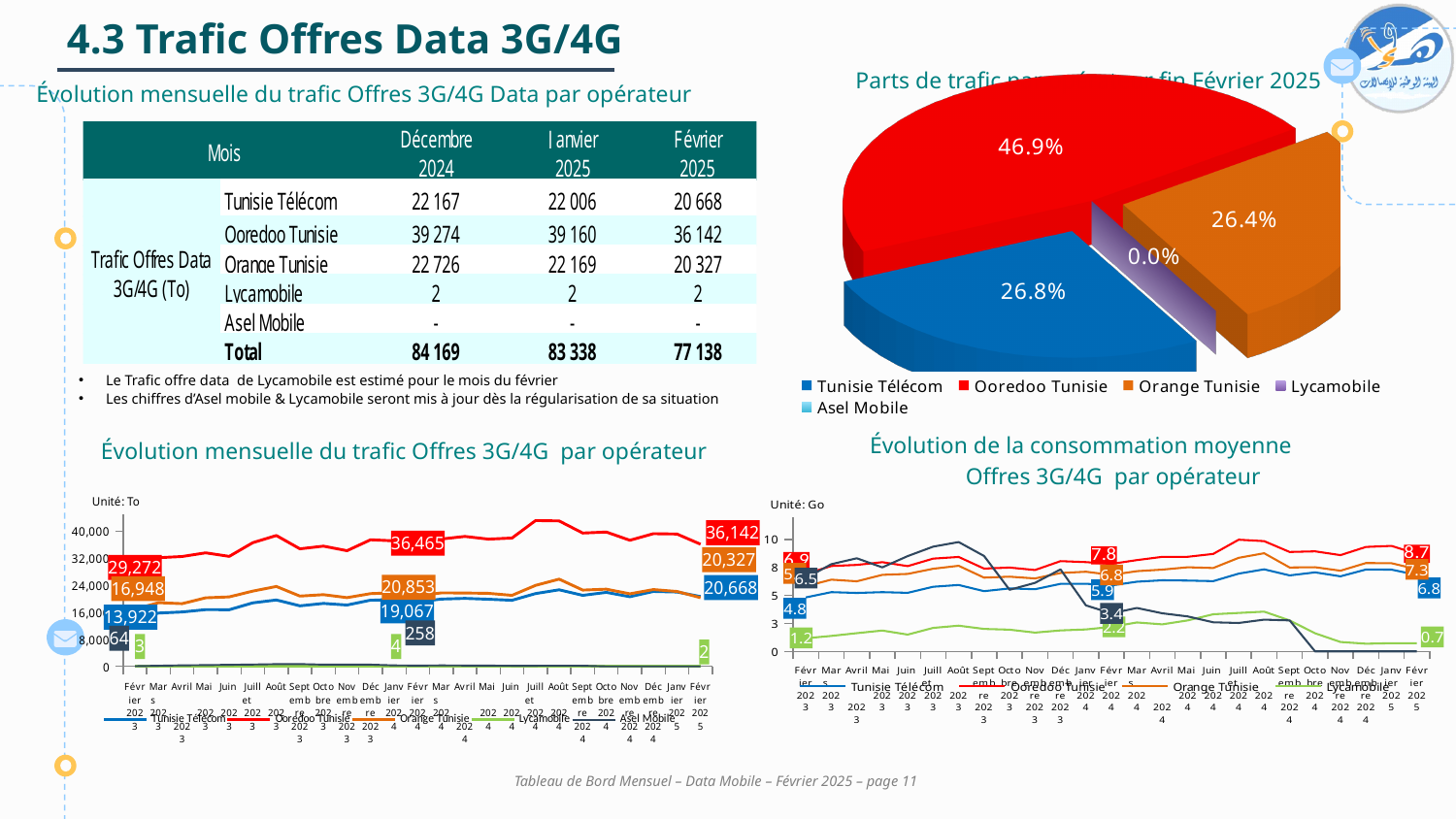
In the pie chart 'Parts de trafic par opérateur fin Février 2025', which operator has the largest slice? Ooredoo Tunisie In the pie chart 'Parts de trafic par opérateur fin Février 2025', what share does Ooredoo Tunisie hold? 46.9% In the bottom-left chart 'Évolution mensuelle du trafic Offres 3G/4G par opérateur', what is the value labelled for Ooredoo Tunisie at Février 2025? 36,142 In the bottom-right chart 'Évolution de la consommation moyenne Offres 3G/4G par opérateur', what is the value labelled for Ooredoo Tunisie at Février 2025? 8.7 How many operators are listed in the legend of the pie chart 'Parts de trafic par opérateur fin Février 2025'? 5 What unit is indicated on the bottom-left chart 'Évolution mensuelle du trafic Offres 3G/4G par opérateur'? To What kind of chart is the bottom-left chart 'Évolution mensuelle du trafic Offres 3G/4G par opérateur'? line chart In the bottom-right chart 'Évolution de la consommation moyenne Offres 3G/4G par opérateur', which is higher at Février 2025: Ooredoo Tunisie or Tunisie Télécom? Ooredoo Tunisie In the bottom-left chart 'Évolution mensuelle du trafic Offres 3G/4G par opérateur', what is the value labelled for Tunisie Télécom at Février 2025? 20,668 What kind of chart is 'Parts de trafic par opérateur fin Février 2025'? pie chart In the bottom-left chart 'Évolution mensuelle du trafic Offres 3G/4G par opérateur', what is the difference between the Février 2025 values of Ooredoo Tunisie (36,142) and Tunisie Télécom (20,668)? 15,474 In the pie chart 'Parts de trafic par opérateur fin Février 2025', what share is shown for Lycamobile? 0.0%